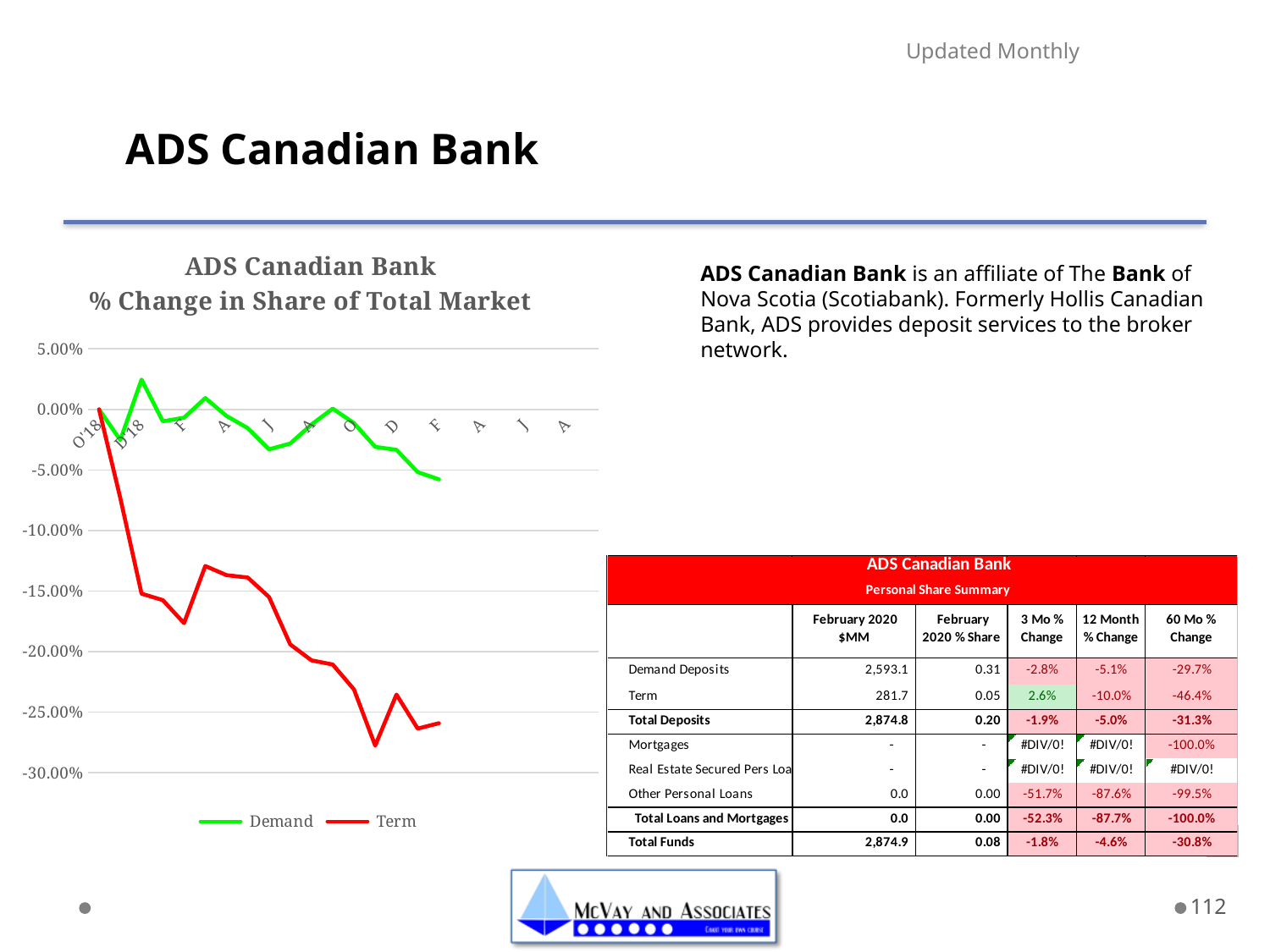
Is the value of the Term line at the third x-axis label (F) greater or less than -15.00%? less Is the value of the Term line at its last plotted point greater or less than -20.00%? less Does the Term line generally rise or fall along the x axis? fall How many series does the chart legend list? 2 What colour is the Term line in the chart? red What are the two series named in the chart legend? Demand and Term Is the value of the Demand line at its last plotted point greater or less than 0.00%? less Which series reaches the lowest value on the chart, Demand or Term? Term What kind of chart is shown on the slide? line chart Which series is lower at the right-hand end of the chart, Demand or Term? Term